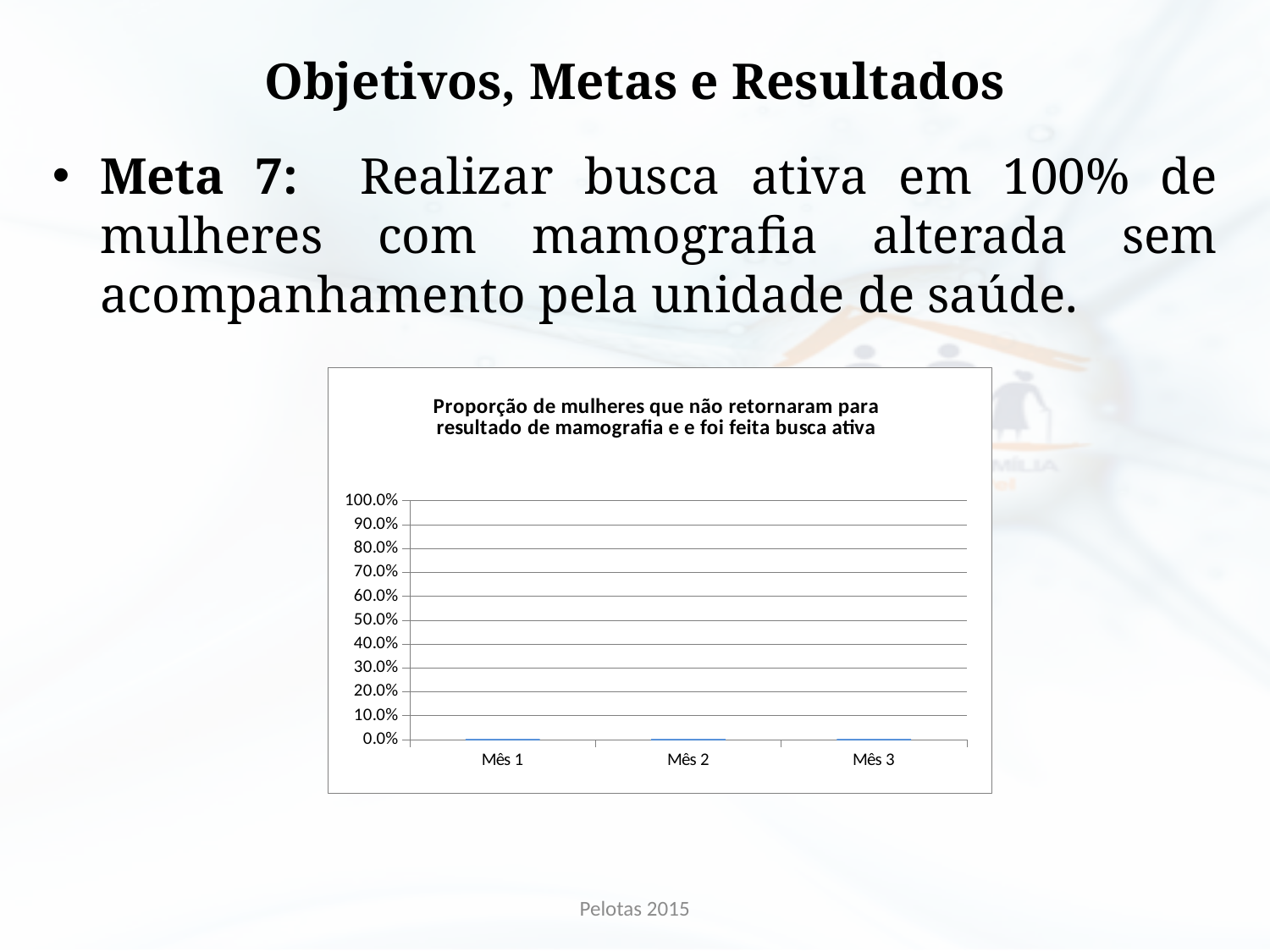
What is the value for Mês 2 in the chart? 0.0% Is the value for Mês 3 greater or less than 10.0%? less What is the title of the chart? Proporção de mulheres que não retornaram para resultado de mamografia e e foi feita busca ativa What is the difference between the values for Mês 1 and Mês 3? 0.0% Is the value for Mês 1 greater or less than 50.0%? less What kind of chart is shown on the slide? bar chart What is the value for Mês 1 in the chart? 0.0% What is the value for Mês 3 in the chart? 0.0% What is the highest value shown on the y axis of the chart? 100.0% How many categories (months) are shown on the x axis of the chart? 3